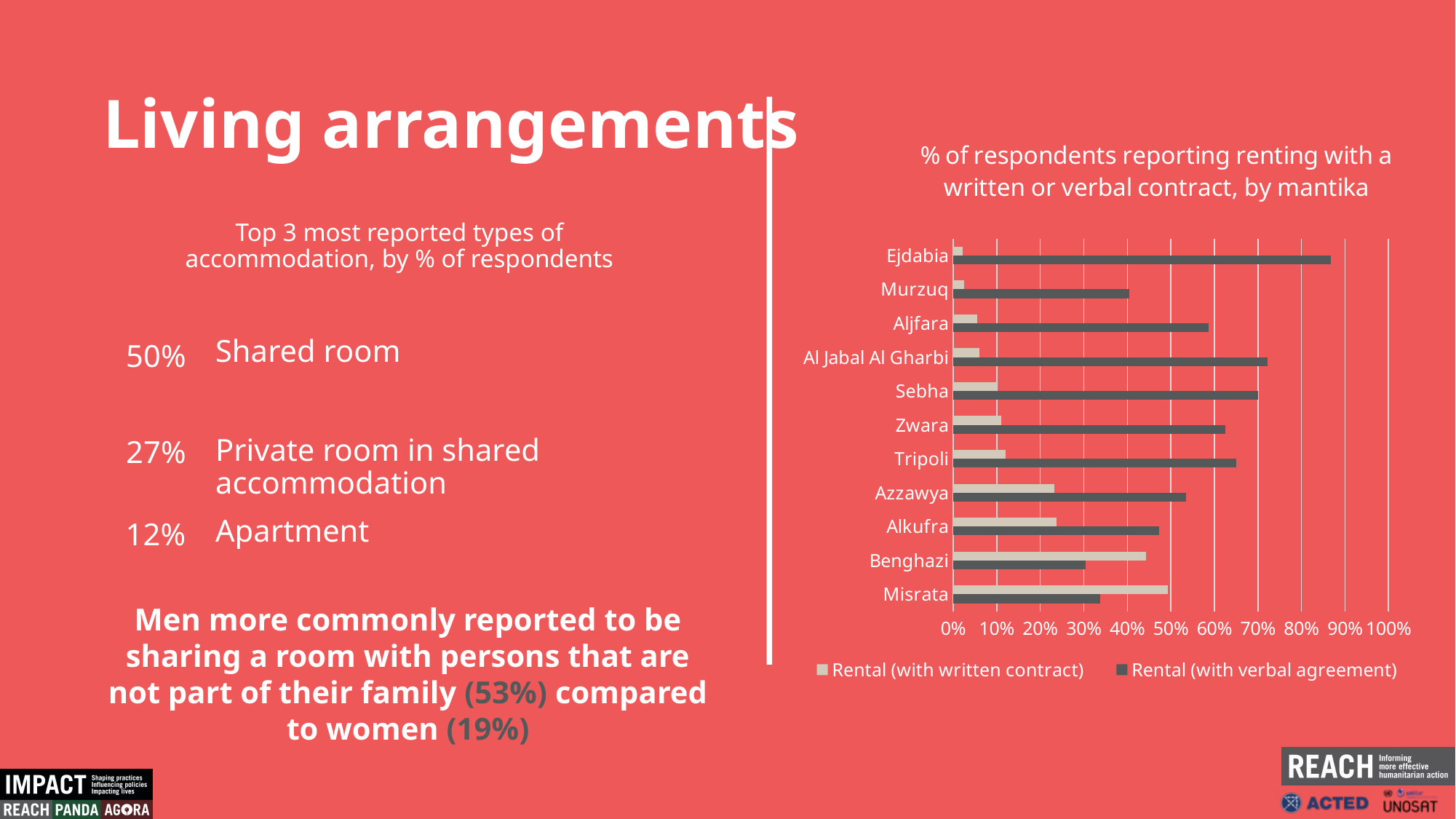
What kind of chart is shown on the slide? Bar chart Which mantika has the highest value for Rental (with verbal agreement)? Ejdabia Which mantika has a larger value for Rental (with verbal agreement): Ejdabia or Murzuq? Ejdabia Is the value for Rental (with verbal agreement) in Ejdabia greater or less than 80%? greater Which mantika has the highest value for Rental (with written contract)? Misrata What is the title of the chart? % of respondents reporting renting with a written or verbal contract, by mantika How many mantikas are listed on the chart? 11 Is the value for Rental (with verbal agreement) in Misrata greater or less than 40%? less How many series does the chart legend list? 2 Is the value for Rental (with written contract) in Benghazi greater or less than 40%? greater Which is larger for Benghazi: Rental (with written contract) or Rental (with verbal agreement)? Rental (with written contract)